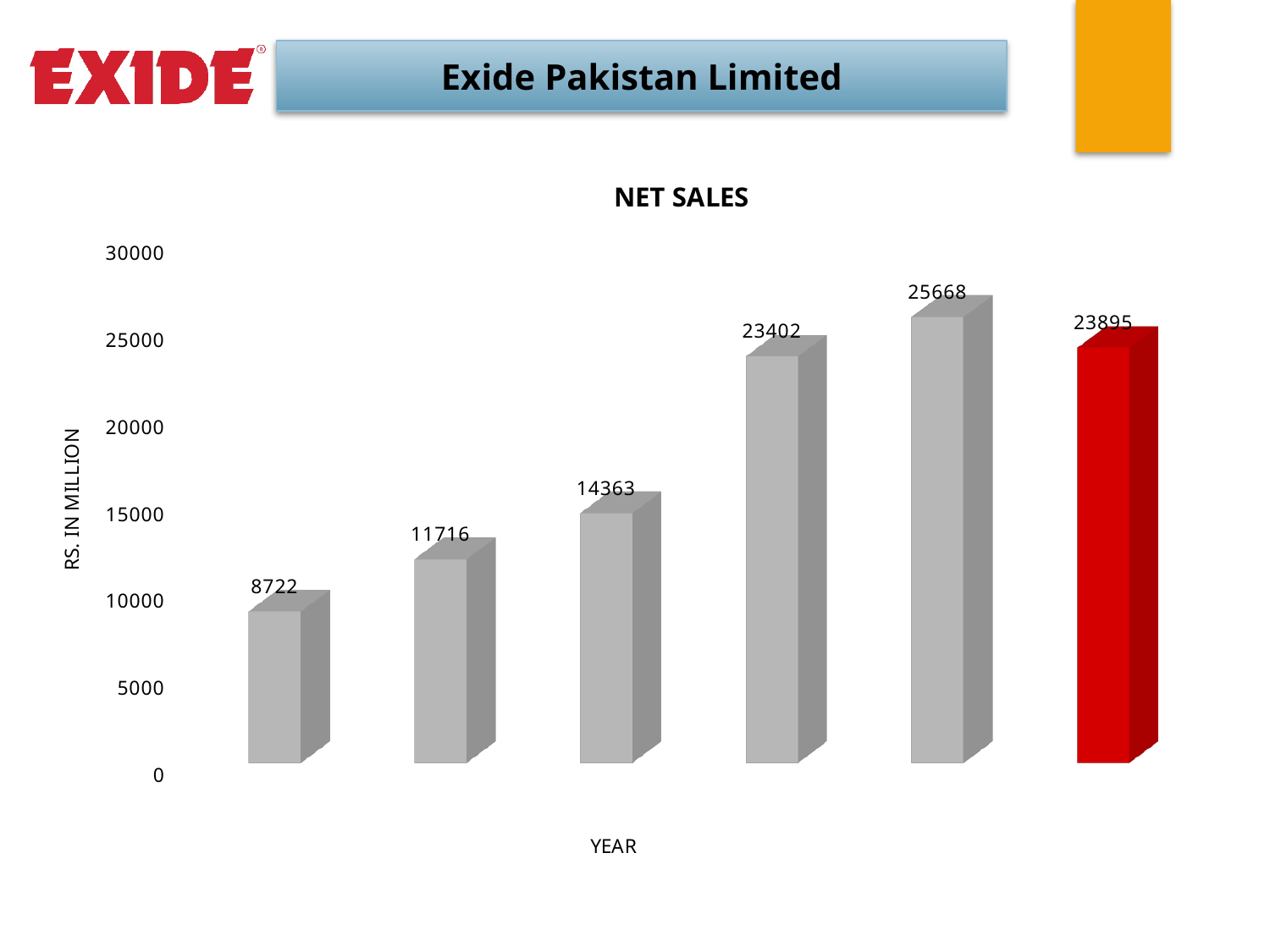
What is the label on the vertical axis? RS. IN MILLION What is the highest value shown in the chart? 25668 What is the value shown on the red bar at the far right? 23895 What is the value shown on the third bar from the left? 14363 Do the values rise or fall from the first bar to the fifth bar? rise What is the value shown on the first (leftmost) bar? 8722 What type of chart is shown on the slide? bar chart What is the title of the chart? NET SALES What is the lowest value shown in the chart? 8722 What is the difference between the fifth bar (25668) and the red bar (23895)? 1773 How many bars are plotted in the NET SALES chart? 6 Which is larger, the fourth bar or the red bar at the far right? the red bar (23895)